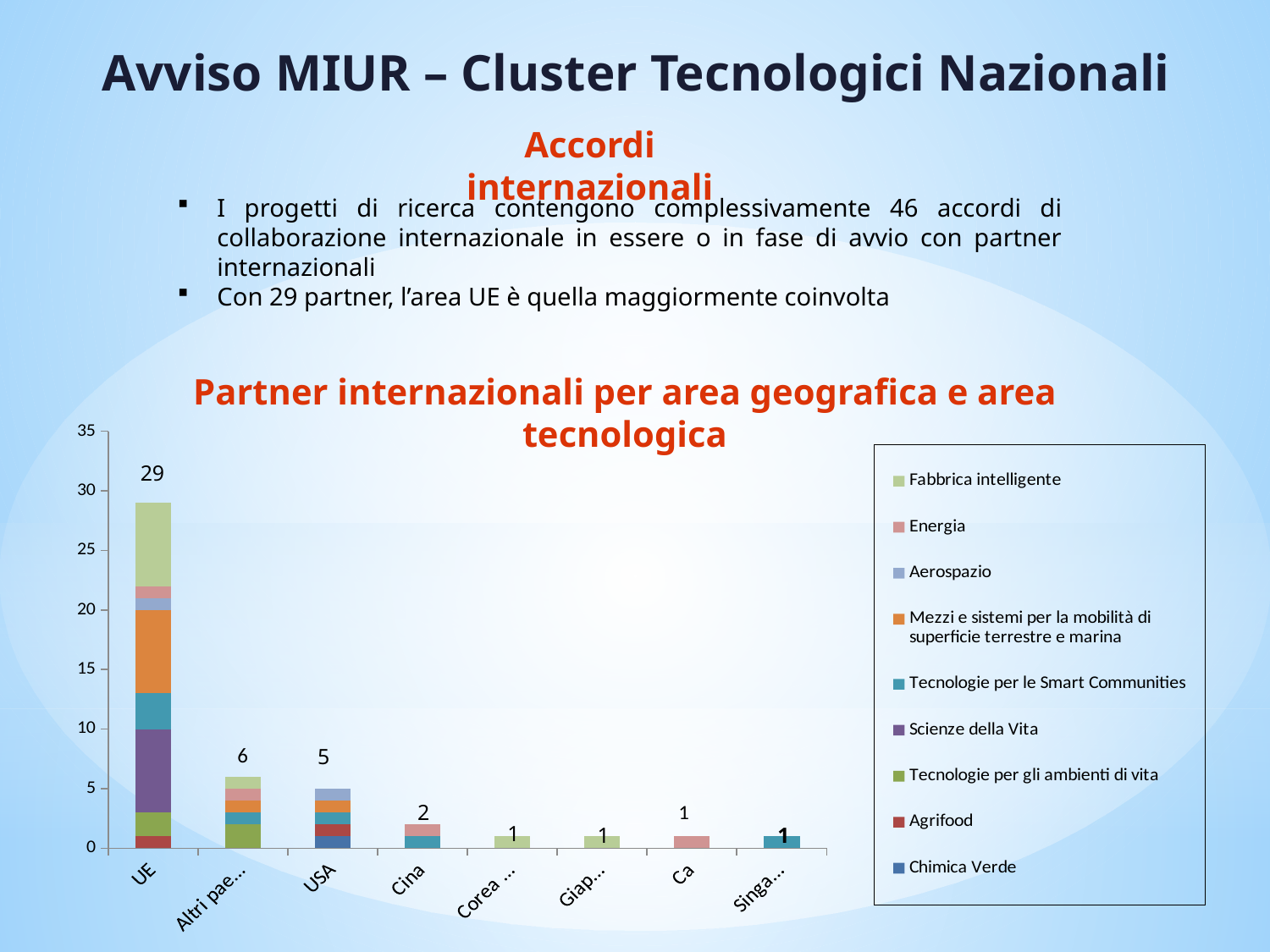
Which geographic area has the highest number of international partners? UE Is the total for UE greater or less than 25? greater What is the total value shown for the USA bar? 5 What is the title of the chart? Partner internazionali per area geografica e area tecnologica How many series does the legend list? 9 How many geographic areas (bars) are shown on the x axis? 8 What is the total value shown for the Cina bar? 2 What kind of chart is shown on the slide? Stacked bar chart Which series is listed first in the chart legend? Fabbrica intelligente What is the difference between the totals for UE and USA? 24 Which has a larger total, USA or Cina? USA What is the total value shown for the UE bar? 29